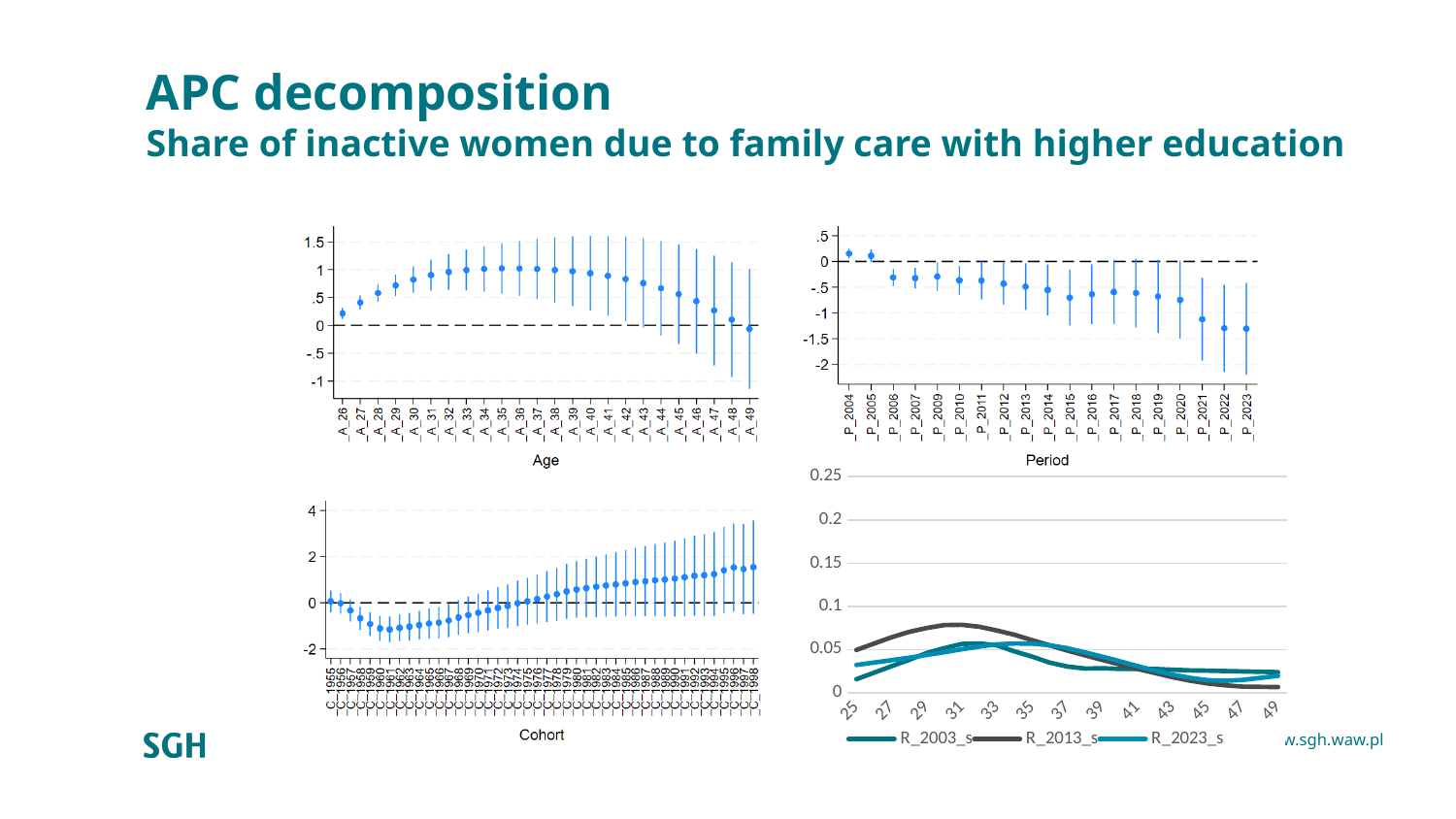
In the bottom-right line chart, how many series does the legend list? 3 In the bottom-right chart, what are the names of the series in the legend? R_2003_s, R_2013_s, R_2023_s In the Cohort chart (bottom left), is the value for C_1998 greater or less than 1? greater In the bottom-right line chart, which series reaches the highest peak value? R_2013_s In the Period chart (top right), is the value for P_2004 greater or less than 0? greater What kind of chart is the bottom-right chart on the slide? line chart In the Period chart (top right), do the point estimates generally rise or fall from P_2004 to P_2023? fall In the Age chart (top left), is the value for A_32 greater or less than 0.5? greater In the Age chart (top left), how many age categories are plotted on the x axis? 24 In the Period chart (top right), how many periods are plotted on the x axis? 19